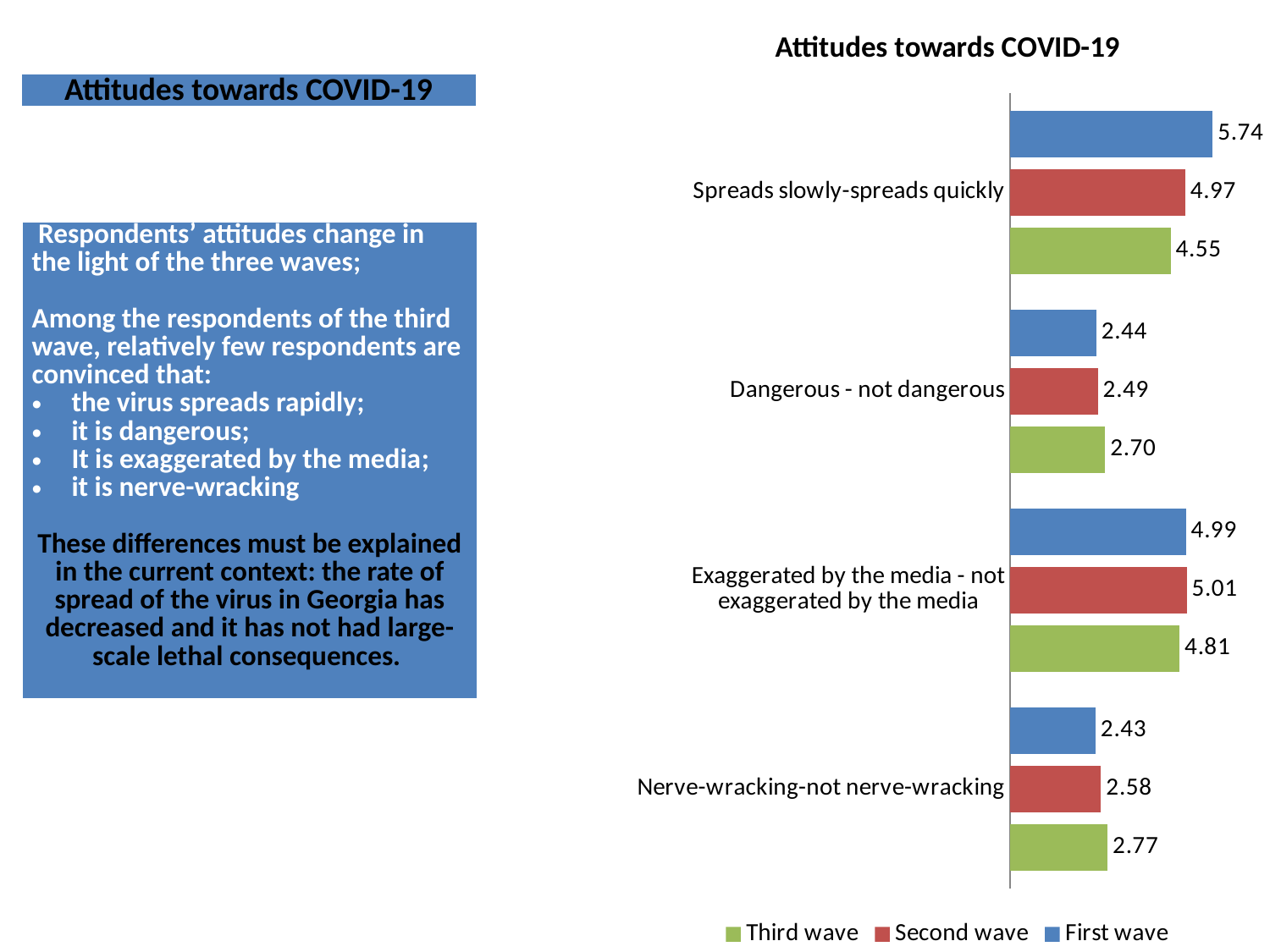
What is the Second wave value for "Exaggerated by the media - not exaggerated by the media"? 5.01 What is the difference between the First wave and Third wave values for "Spreads slowly-spreads quickly"? 1.19 What kind of chart is shown on the slide? Bar chart Which category has the highest First wave value? Spreads slowly-spreads quickly What is the Third wave value for "Dangerous - not dangerous"? 2.70 What is the Third wave value for "Nerve-wracking-not nerve-wracking"? 2.77 Which category has the lowest Second wave value? Dangerous - not dangerous What is the First wave value for "Spreads slowly-spreads quickly"? 5.74 What is the title of the chart? Attitudes towards COVID-19 How many series does the legend list? 3 How many categories are shown on the chart? 4 For "Nerve-wracking-not nerve-wracking", which is larger: the First wave value or the Third wave value? Third wave